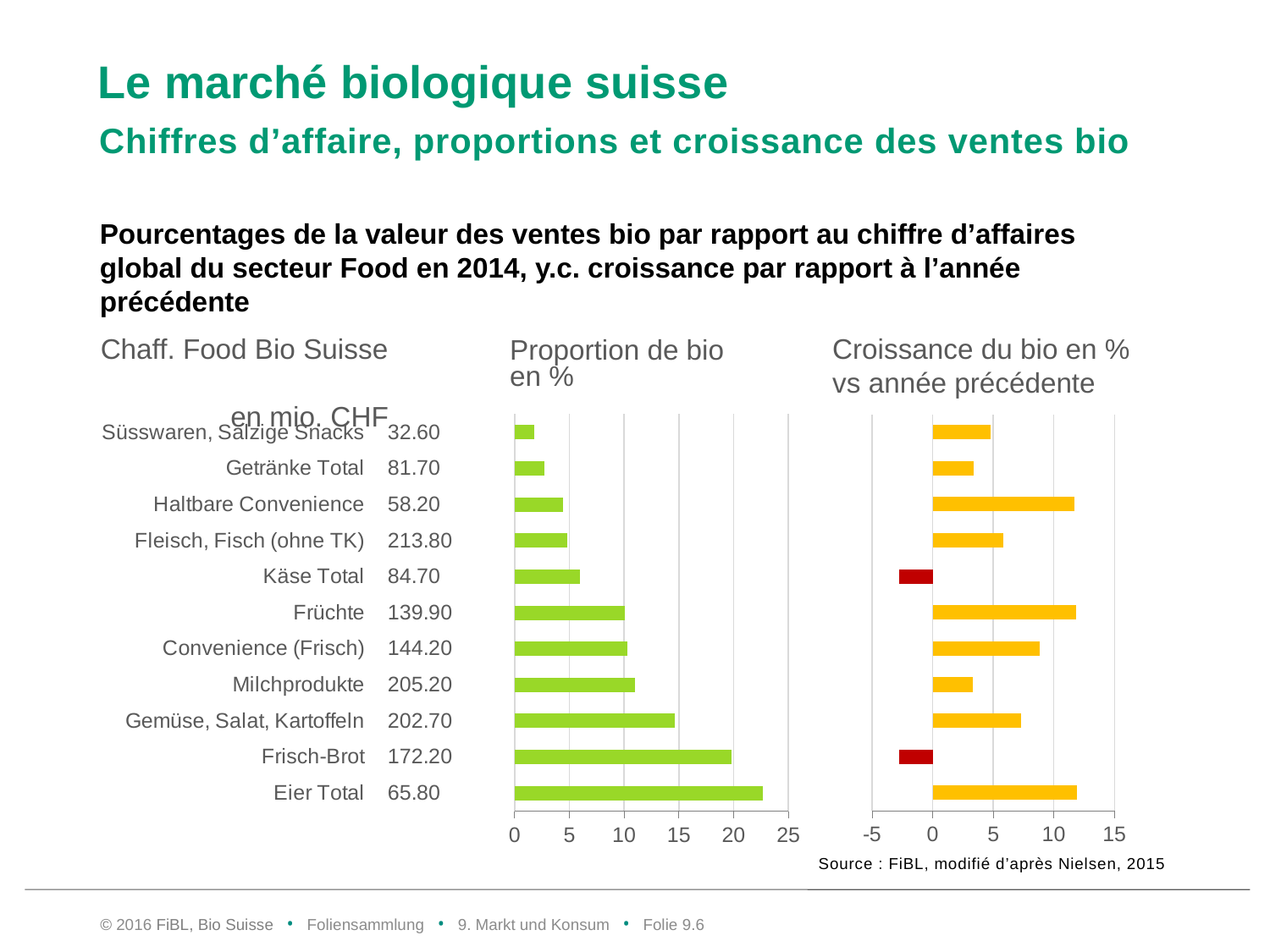
What kind of chart is the 'Proportion de bio en %' chart? bar chart In the 'Proportion de bio en %' chart, is the value for Käse Total greater or less than 10? less In the 'Proportion de bio en %' chart, which is larger: Gemüse, Salat, Kartoffeln or Milchprodukte? Gemüse, Salat, Kartoffeln In the 'Croissance du bio en % vs année précédente' chart, is the value for Käse Total greater or less than 0? less In the 'Croissance du bio en % vs année précédente' chart, what colour are the bars for the categories with negative growth? red In the 'Croissance du bio en % vs année précédente' chart, is the value for Haltbare Convenience greater or less than 10? greater In the 'Proportion de bio en %' chart, which category has the highest value? Eier Total How many product categories are shown in the 'Proportion de bio en %' chart? 11 In the 'Croissance du bio en % vs année précédente' chart, how many categories show negative growth? 2 In the 'Proportion de bio en %' chart, which category has the lowest value? Süsswaren, Salzige Snacks